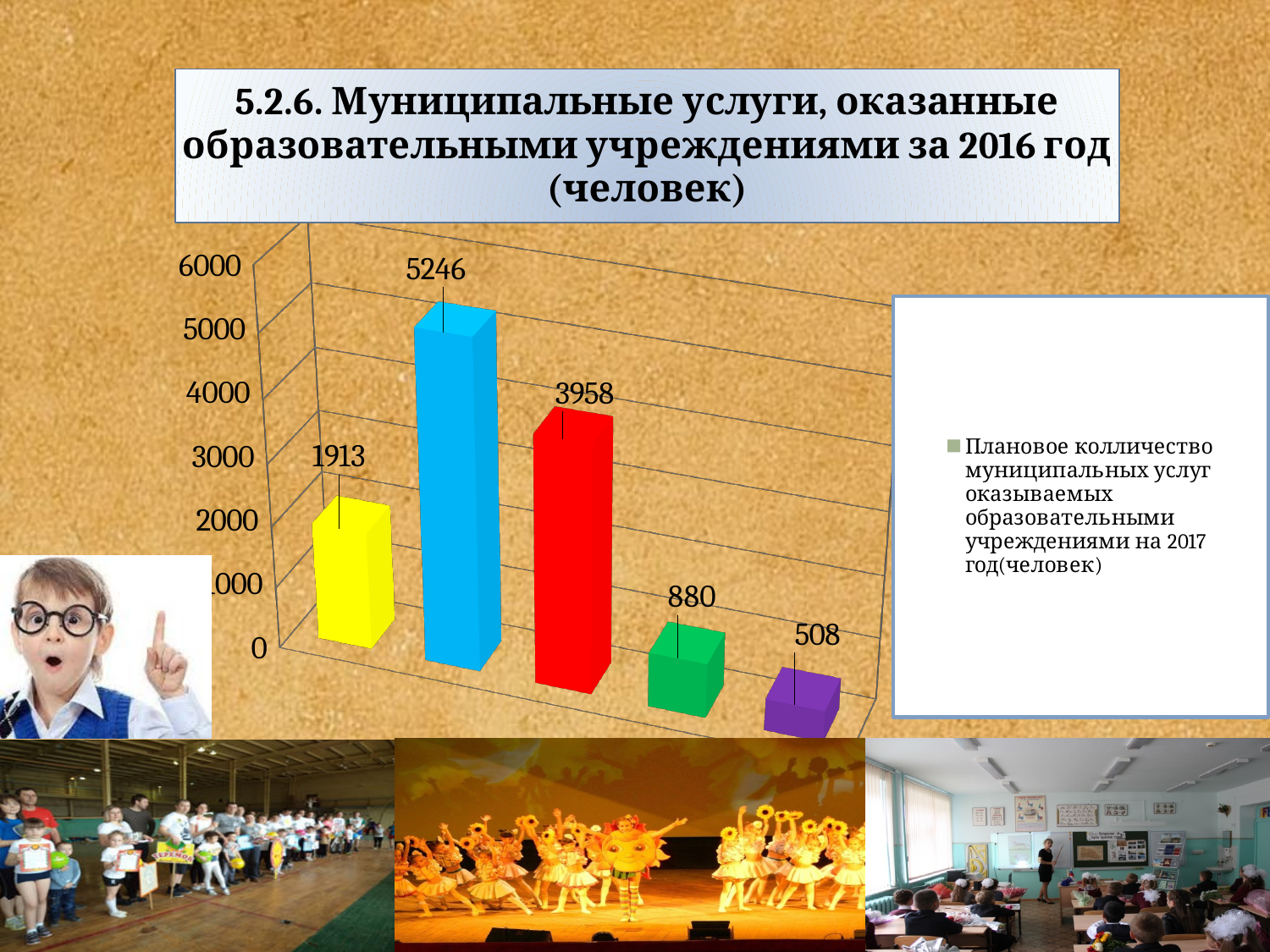
What is the value shown on the blue bar? 5246 What is the value shown on the red bar? 3958 What is the value shown on the yellow bar? 1913 Which bar has the highest value? the blue bar (5246) What is the value shown on the purple bar? 508 Which is larger, the green bar or the yellow bar? the yellow bar What is the highest value shown on the vertical axis? 6000 What is the difference between the blue bar (5246) and the red bar (3958)? 1288 What type of chart is shown on the slide? bar chart How many bars are plotted in the chart? 5 How many series does the legend list? 1 Which bar has the lowest value? the purple bar (508)